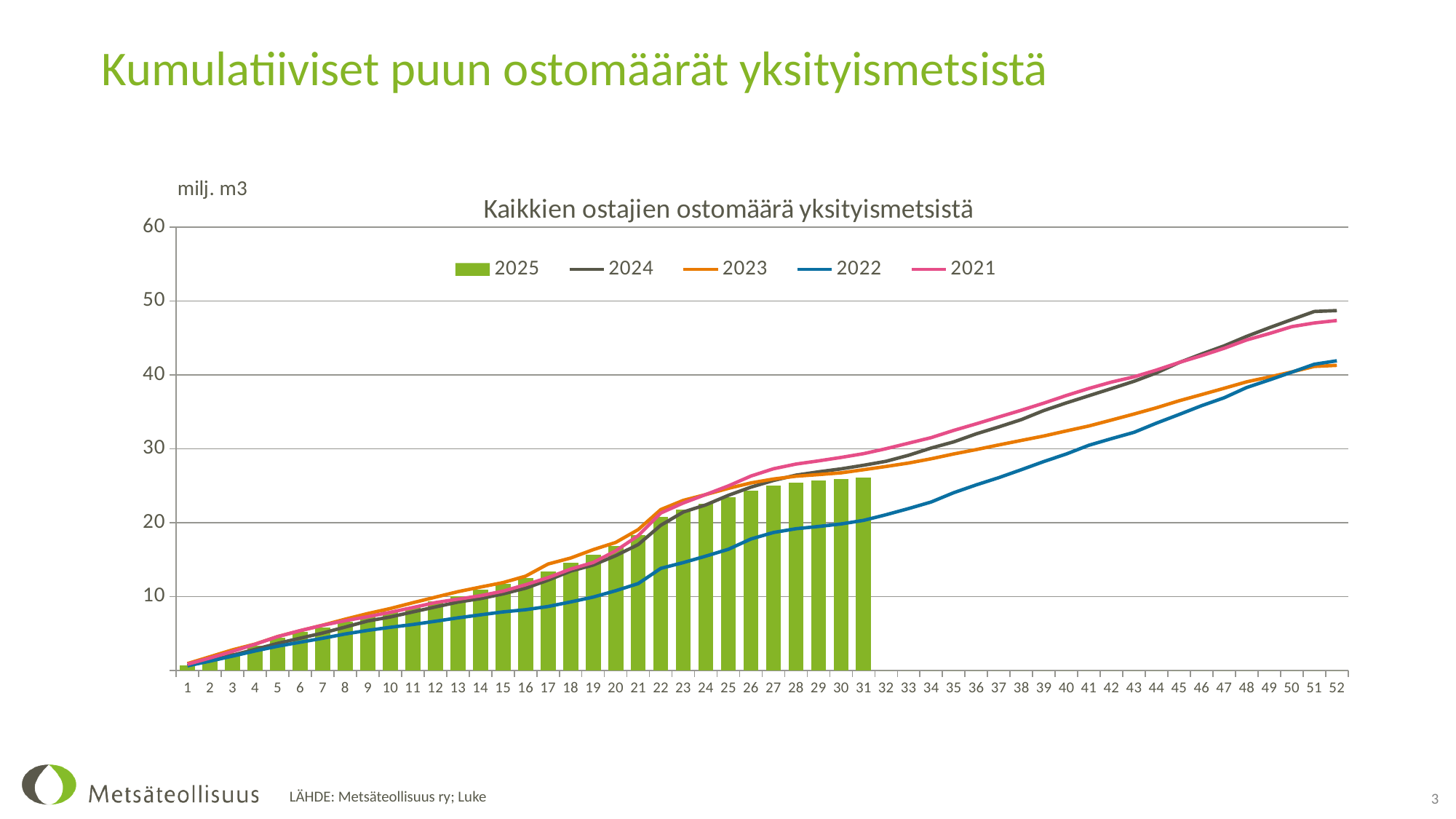
How many weeks are labelled on the x axis? 52 At week 52, which is larger, the 2024 value or the 2022 value? 2024 Is the 2025 value at week 31 greater or less than 30? less What is the title of the chart? Kaikkien ostajien ostomäärä yksityismetsistä Which series is shown as bars rather than a line? 2025 Which series has the lowest value at week 31? 2022 Is the 2025 value at week 31 greater or less than 20? greater Is the 2024 value at week 52 greater or less than 50? less Do the values rise or fall along the x axis? Rise How many series does the legend list? 5 What kind of chart is this? A combined bar and line chart Up to which week are bars plotted for 2025? 31